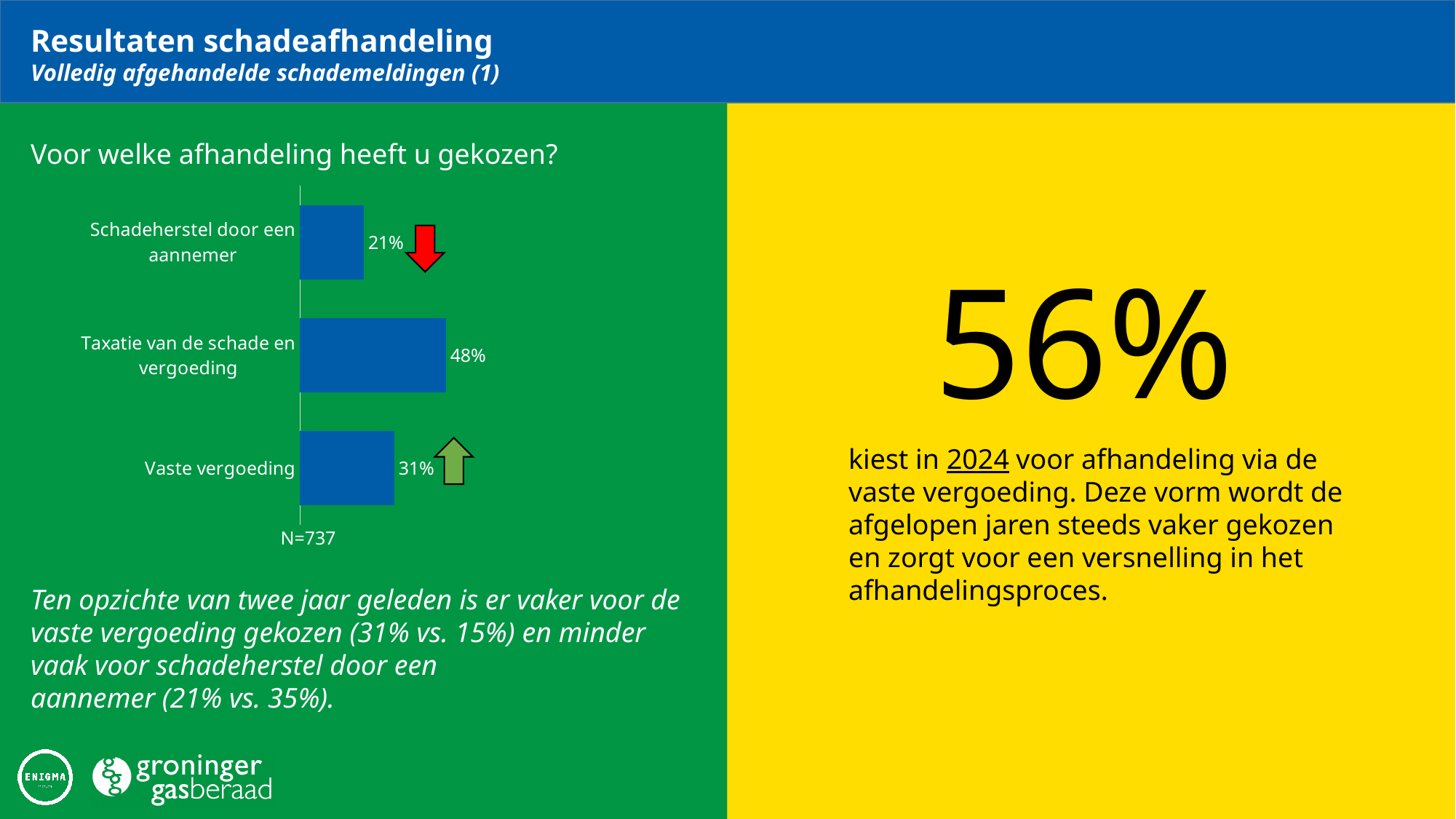
What is the difference between 'Taxatie van de schade en vergoeding' and 'Vaste vergoeding'? 17% Which is larger: 'Vaste vergoeding' or 'Schadeherstel door een aannemer'? Vaste vergoeding Which category has the highest value? Taxatie van de schade en vergoeding What is the difference between 'Vaste vergoeding' and 'Schadeherstel door een aannemer'? 10% What kind of chart is shown on the slide? Bar chart What is the value for 'Schadeherstel door een aannemer'? 21% What is the sample size (N) shown below the chart? N=737 How many categories are shown in the chart? 3 Which category has the lowest value? Schadeherstel door een aannemer What is the value for 'Taxatie van de schade en vergoeding'? 48% What is the value for 'Vaste vergoeding'? 31% What is the title of the chart? Voor welke afhandeling heeft u gekozen?